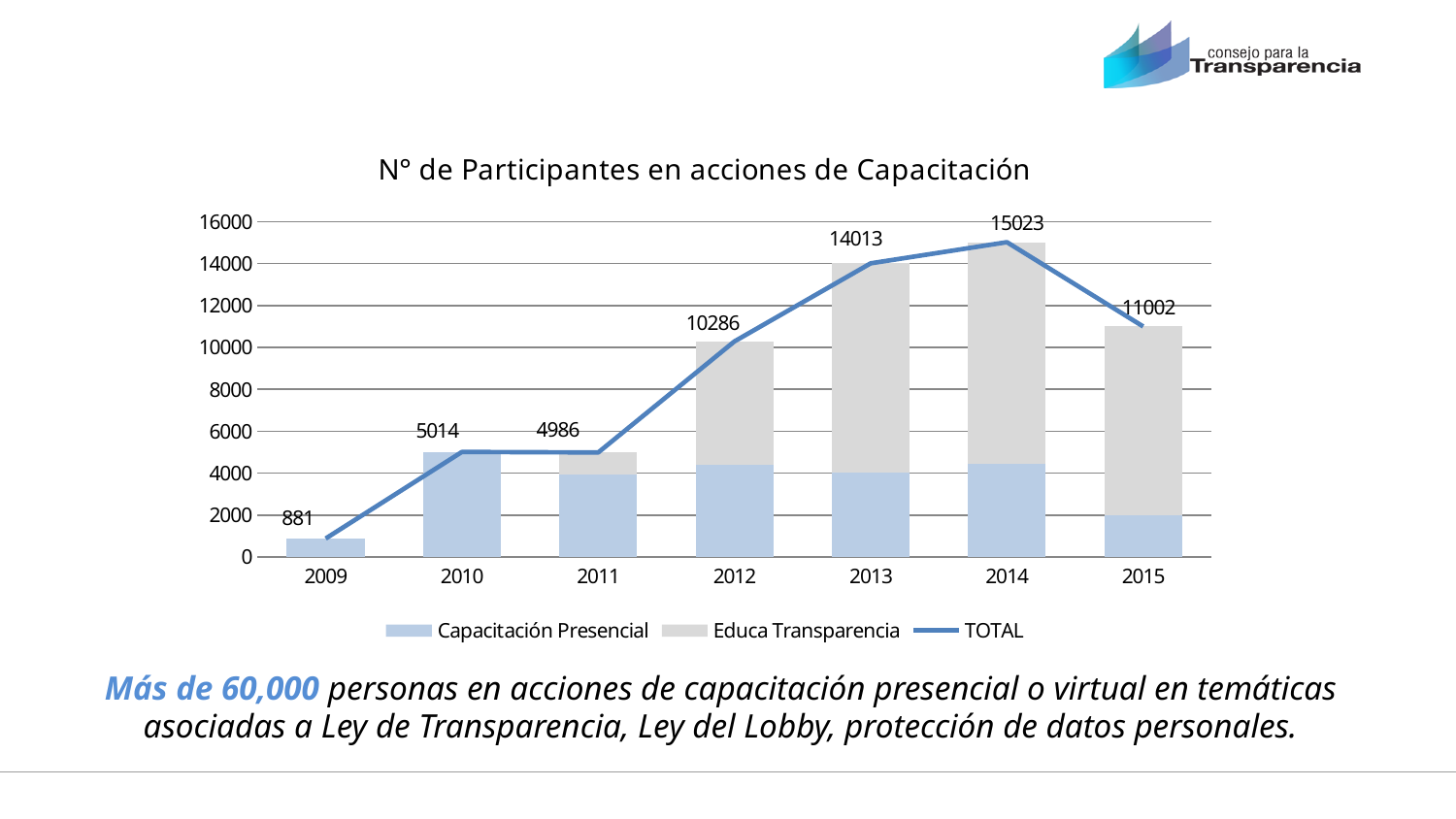
What is the title of the chart? N° de Participantes en acciones de Capacitación What is the TOTAL value for 2012? 10286 Does the TOTAL rise or fall from 2009 to 2014? rise What is the difference between the TOTAL for 2014 and the TOTAL for 2015? 4021 Which year has the highest TOTAL? 2014 How many series does the legend list? 3 What is the TOTAL value for 2014? 15023 Which year has the lowest TOTAL? 2009 Which is larger, the TOTAL for 2010 or the TOTAL for 2011? 2010 How many years are shown on the x axis? 7 What is the TOTAL value for 2009? 881 Is the Capacitación Presencial value for 2014 greater or less than 6000? less